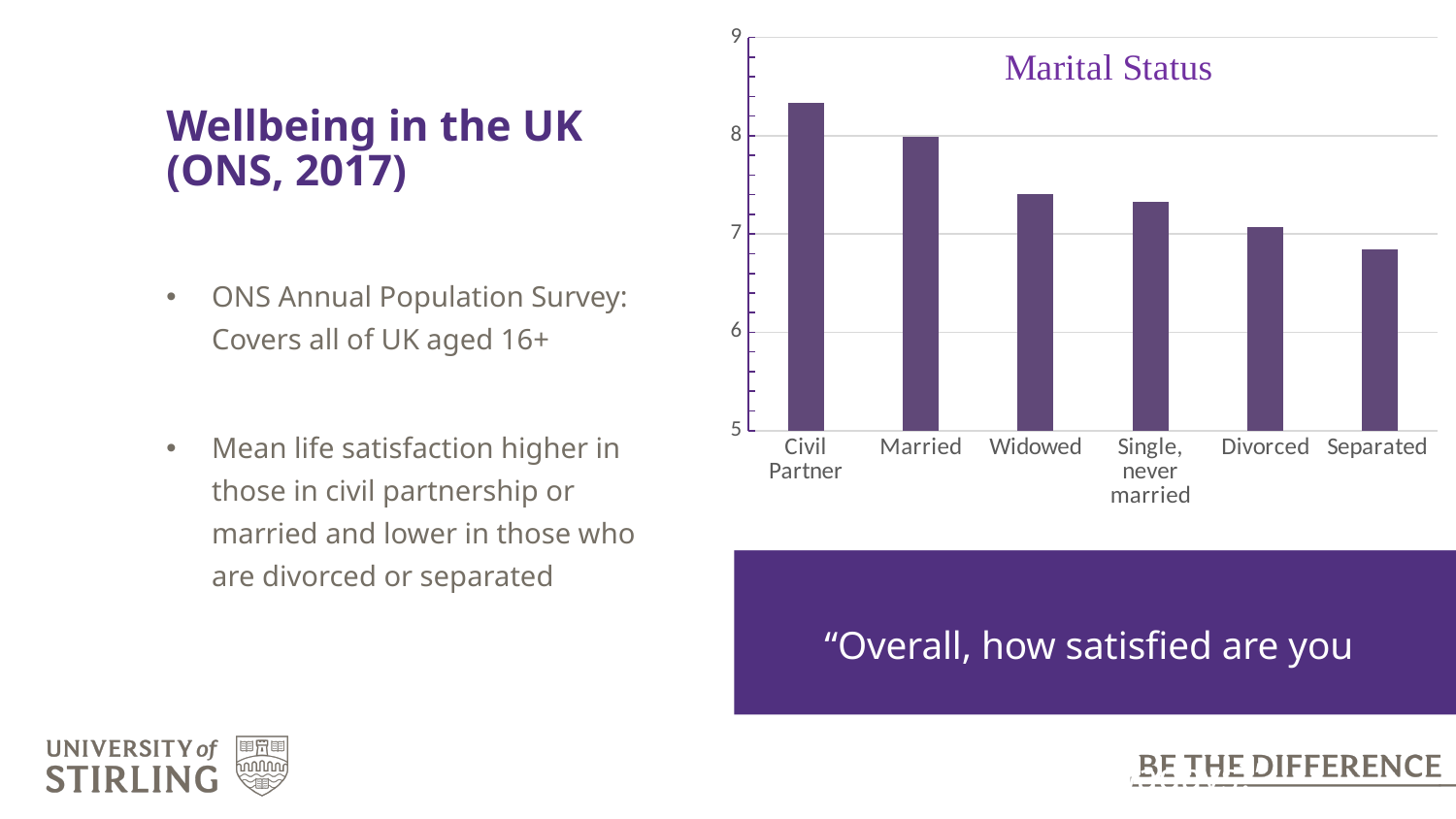
Do the bar values rise or fall moving from left to right across the categories? Fall Is the value for Widowed greater or less than 8? less Is the value for Separated greater or less than 7? less What kind of chart is shown on the slide? Bar chart What is the lowest value shown on the vertical axis of the chart? 5 Which marital status category has the highest bar? Civil Partner Which marital status category has the lowest bar? Separated Is the value for Civil Partner greater or less than 8? greater Which is larger, the value for Married or the value for Widowed? Married What is the title of the chart? Marital Status How many marital status categories are plotted in the chart? 6